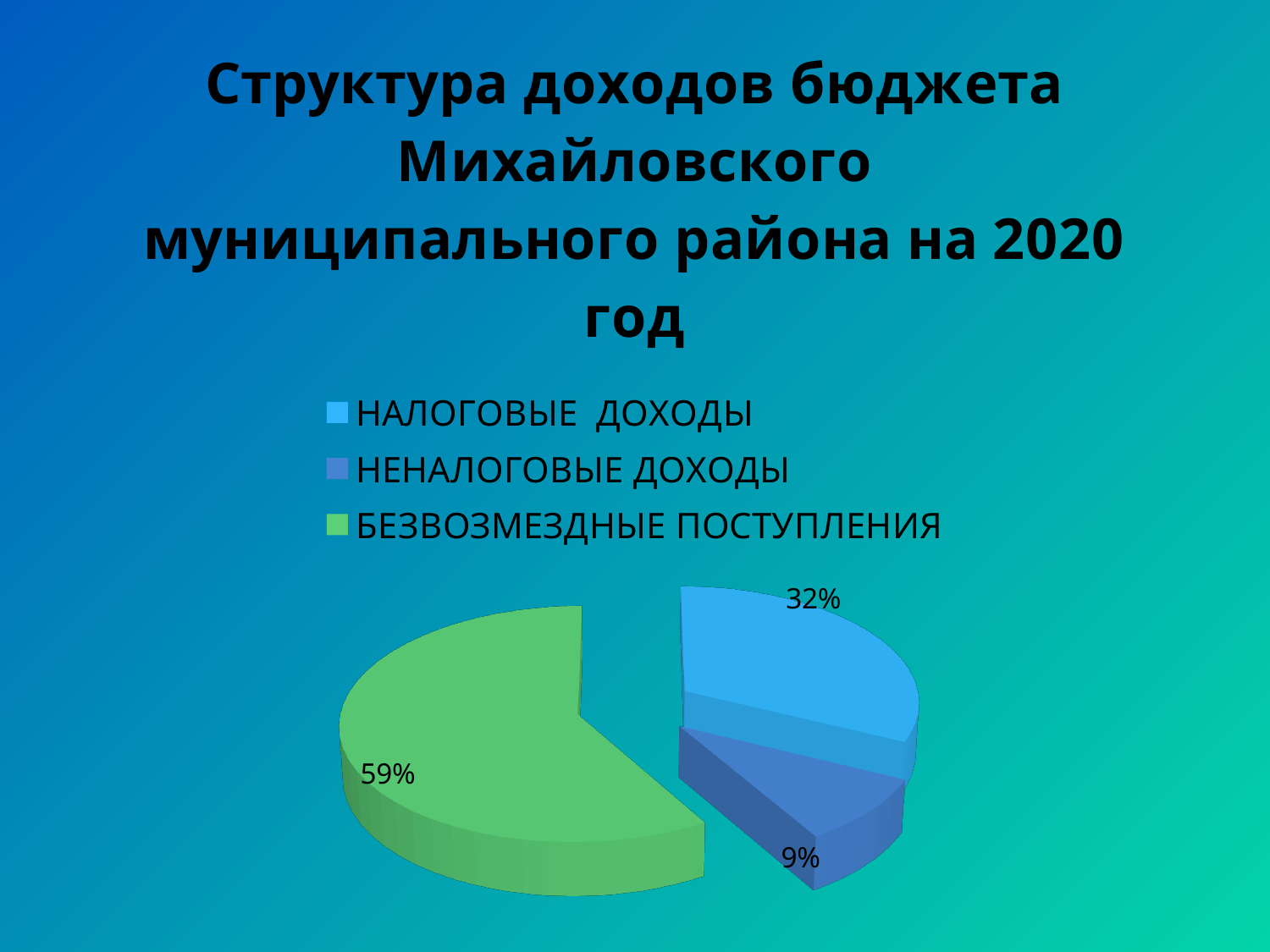
What share of the pie does НАЛОГОВЫЕ ДОХОДЫ represent? 32% What share of the pie does БЕЗВОЗМЕЗДНЫЕ ПОСТУПЛЕНИЯ represent? 59% Which category has the smallest slice of the pie? НЕНАЛОГОВЫЕ ДОХОДЫ Which category has the largest slice of the pie? БЕЗВОЗМЕЗДНЫЕ ПОСТУПЛЕНИЯ What kind of chart is shown on the slide? pie chart What is the difference in percentage points between БЕЗВОЗМЕЗДНЫЕ ПОСТУПЛЕНИЯ and НАЛОГОВЫЕ ДОХОДЫ? 27% What share of the pie does НЕНАЛОГОВЫЕ ДОХОДЫ represent? 9% How many categories does the pie chart have? 3 What colour is the slice for БЕЗВОЗМЕЗДНЫЕ ПОСТУПЛЕНИЯ? green What is the title of the slide containing the chart? Структура доходов бюджета Михайловского муниципального района на 2020 год What is the difference in percentage points between НАЛОГОВЫЕ ДОХОДЫ and НЕНАЛОГОВЫЕ ДОХОДЫ? 23% Which is larger, the share for НАЛОГОВЫЕ ДОХОДЫ or the share for НЕНАЛОГОВЫЕ ДОХОДЫ? НАЛОГОВЫЕ ДОХОДЫ